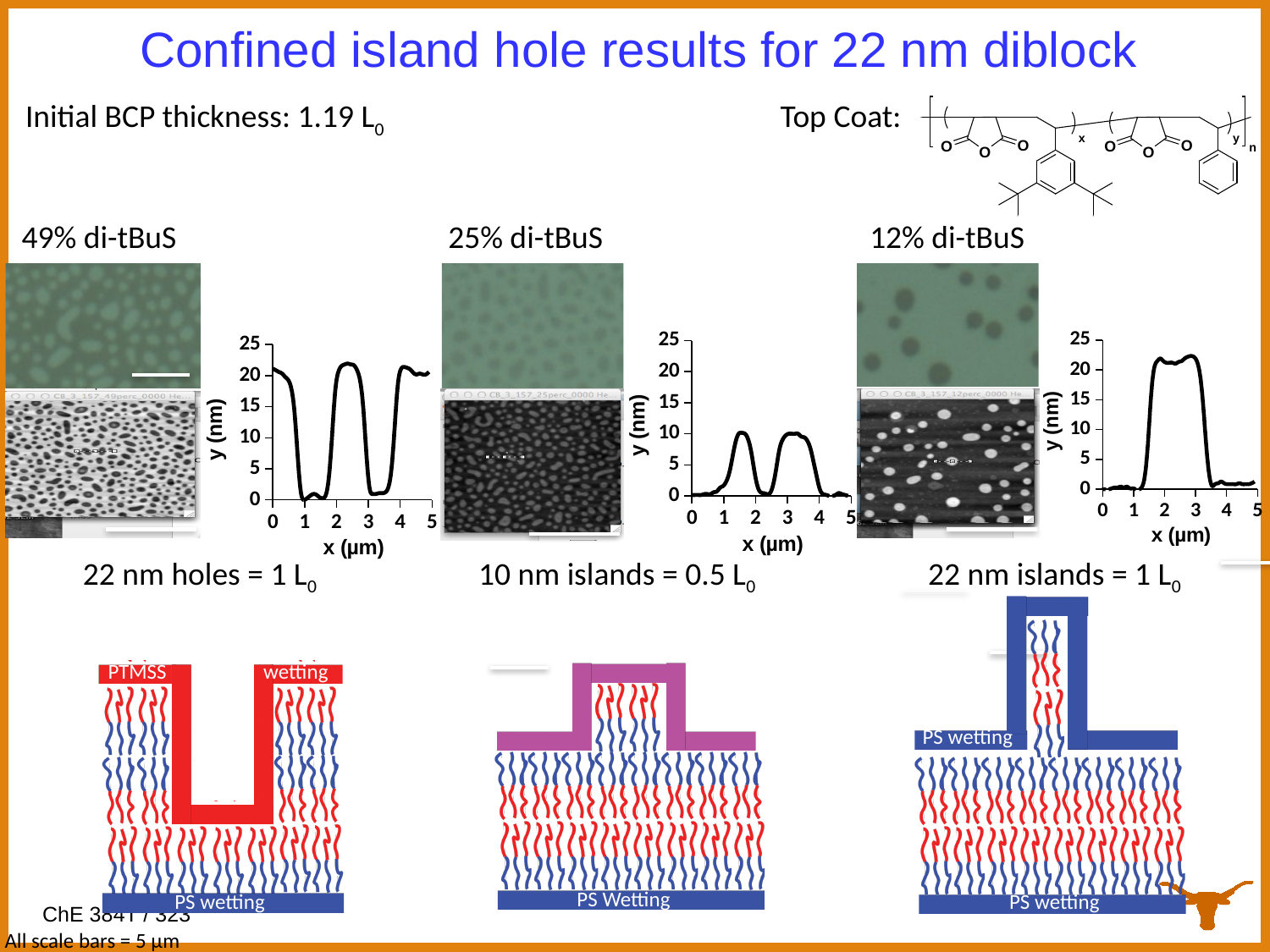
In the chart under 25% di-tBuS, is the peak height of the profile greater or less than 15 nm? less In the chart under 12% di-tBuS, does the profile rise or fall between x = 1 µm and x = 2 µm? rise In the chart under 49% di-tBuS, is the value at x = 0 µm greater or less than 15 nm? greater In the chart under 25% di-tBuS, is the value at x = 0 µm greater or less than 5 nm? less Which chart shows a higher peak in its profile: the one under 25% di-tBuS or the one under 12% di-tBuS? 12% di-tBuS What is the highest tick value on the x axis of the chart under 12% di-tBuS? 5 What type of chart is used under the 49% di-tBuS label? line chart What is the label of the y axis on the chart under 49% di-tBuS? y (nm) How many line charts of y (nm) versus x (µm) are shown on the slide? 3 In the chart under 25% di-tBuS, how many peaks does the profile show? 2